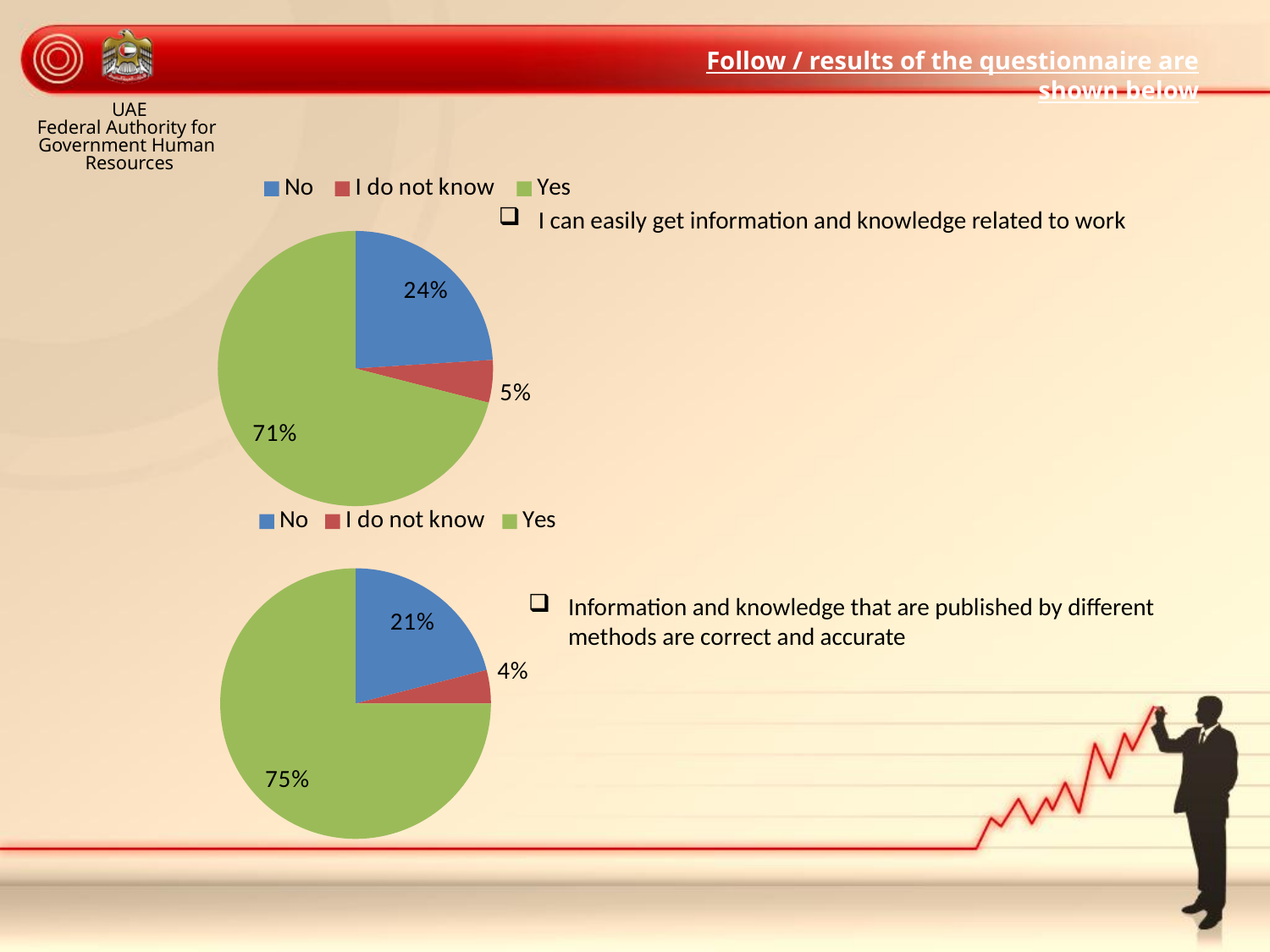
What type of chart is used on this slide? Pie chart In the bottom pie chart, which response has the smallest share? I do not know In the bottom pie chart, what percentage of respondents answered Yes? 75% In the top pie chart, what percentage of respondents answered 'I do not know'? 5% In the bottom pie chart, what percentage of respondents answered No? 21% Which chart has a larger Yes share, the top pie chart or the bottom pie chart? The bottom pie chart In the bottom pie chart, what percentage of respondents answered 'I do not know'? 4% In the top pie chart, what percentage of respondents answered No? 24% In the top pie chart, what percentage of respondents answered Yes? 71% In the top pie chart, what is the difference in percentage points between the Yes and No shares? 47 In the top pie chart, which response has the largest share? Yes How many categories does the legend of the top pie chart list? 3